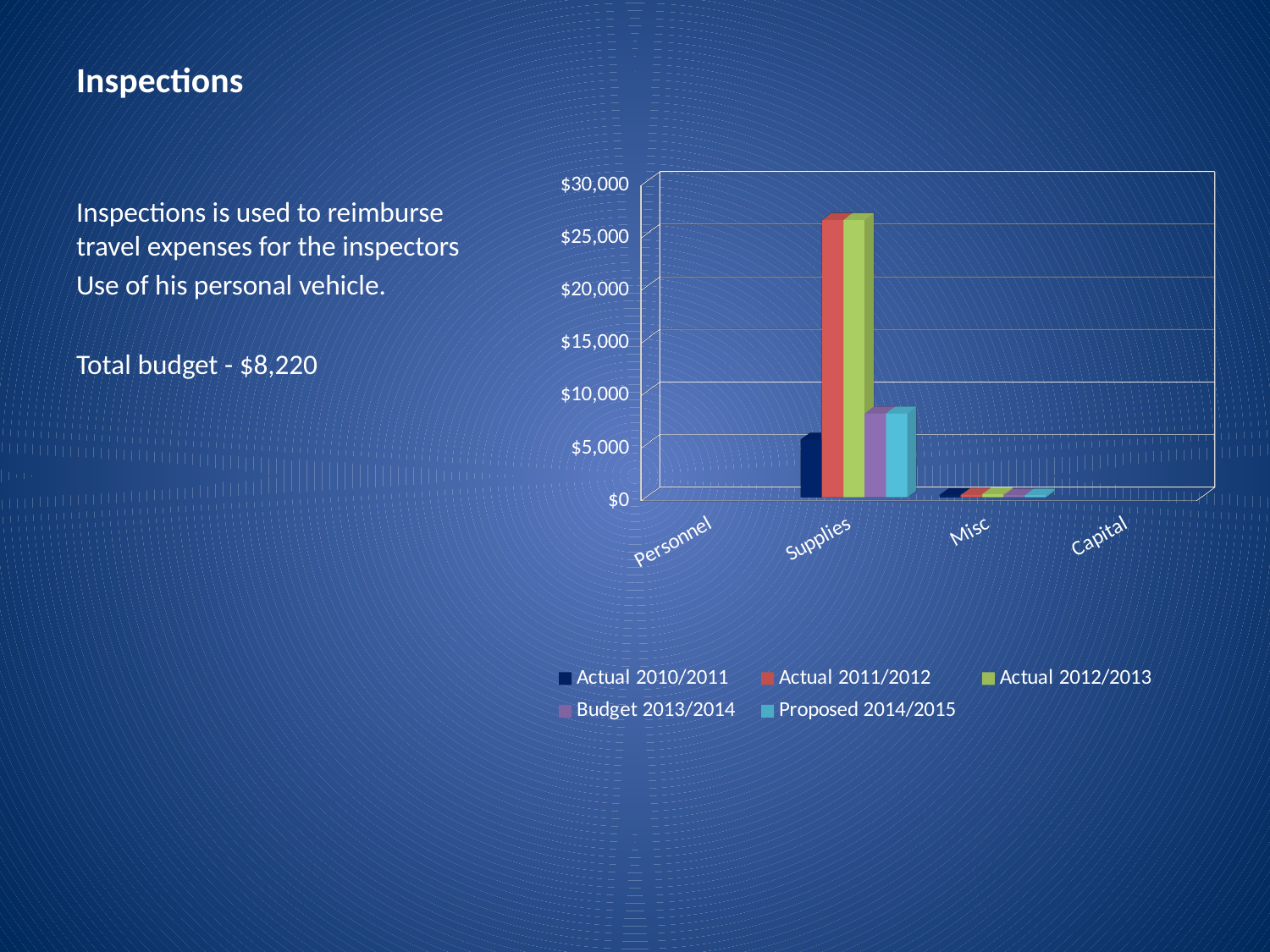
What kind of chart is shown on the slide? bar chart What is the highest value labelled on the chart's vertical axis? $30,000 Which category has the tallest bars in the chart? Supplies Is the Budget 2013/2014 value for Supplies greater or less than $10,000? less Which series is shown in the legend as the last entry? Proposed 2014/2015 Is the Actual 2011/2012 value for Supplies greater or less than $20,000? greater For Supplies, which is larger: the Actual 2012/2013 value or the Proposed 2014/2015 value? Actual 2012/2013 How many series does the chart's legend list? 5 Is the Actual 2010/2011 value for Supplies greater or less than $10,000? less For Supplies, which is larger: the Actual 2011/2012 value or the Actual 2010/2011 value? Actual 2011/2012 How many categories are shown on the x axis of the chart? 4